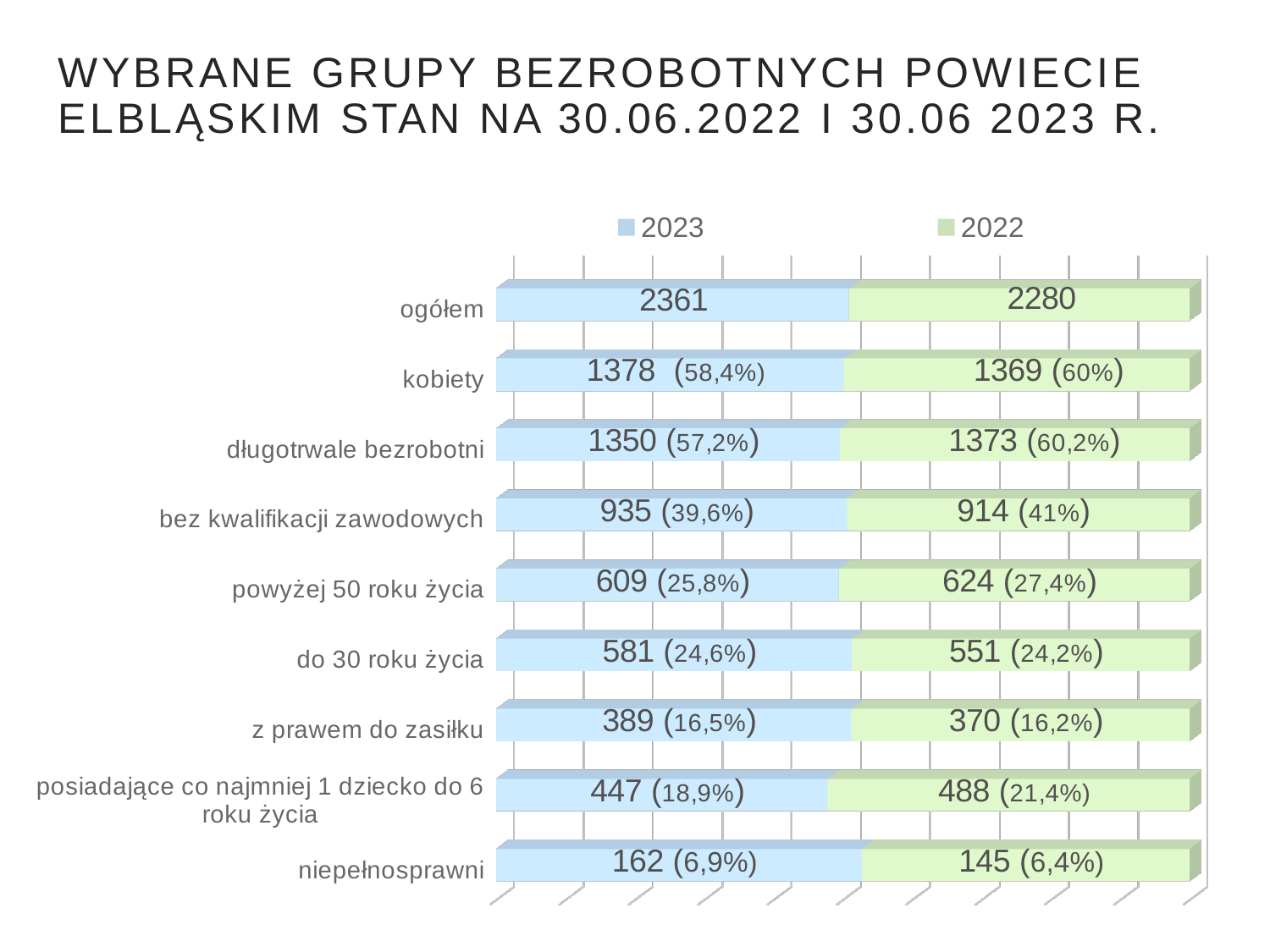
What is the difference between the 2022 and 2023 values for "posiadające co najmniej 1 dziecko do 6 roku życia"? 41 How many series does the legend list? 2 What is the difference between the 2023 and 2022 values for "ogółem"? 81 Which category has the highest 2022 value? ogółem What kind of chart is shown on the slide? bar chart What is the 2023 value for "ogółem"? 2361 What is the 2023 value for "bez kwalifikacji zawodowych"? 935 What percentage is shown next to the 2023 value for "długotrwale bezrobotni"? 57,2% How many categories are shown on the chart? 9 What is the 2022 value for "niepełnosprawni"? 145 Which category has the lowest 2023 value? niepełnosprawni For "kobiety", which year has the larger value, 2023 or 2022? 2023